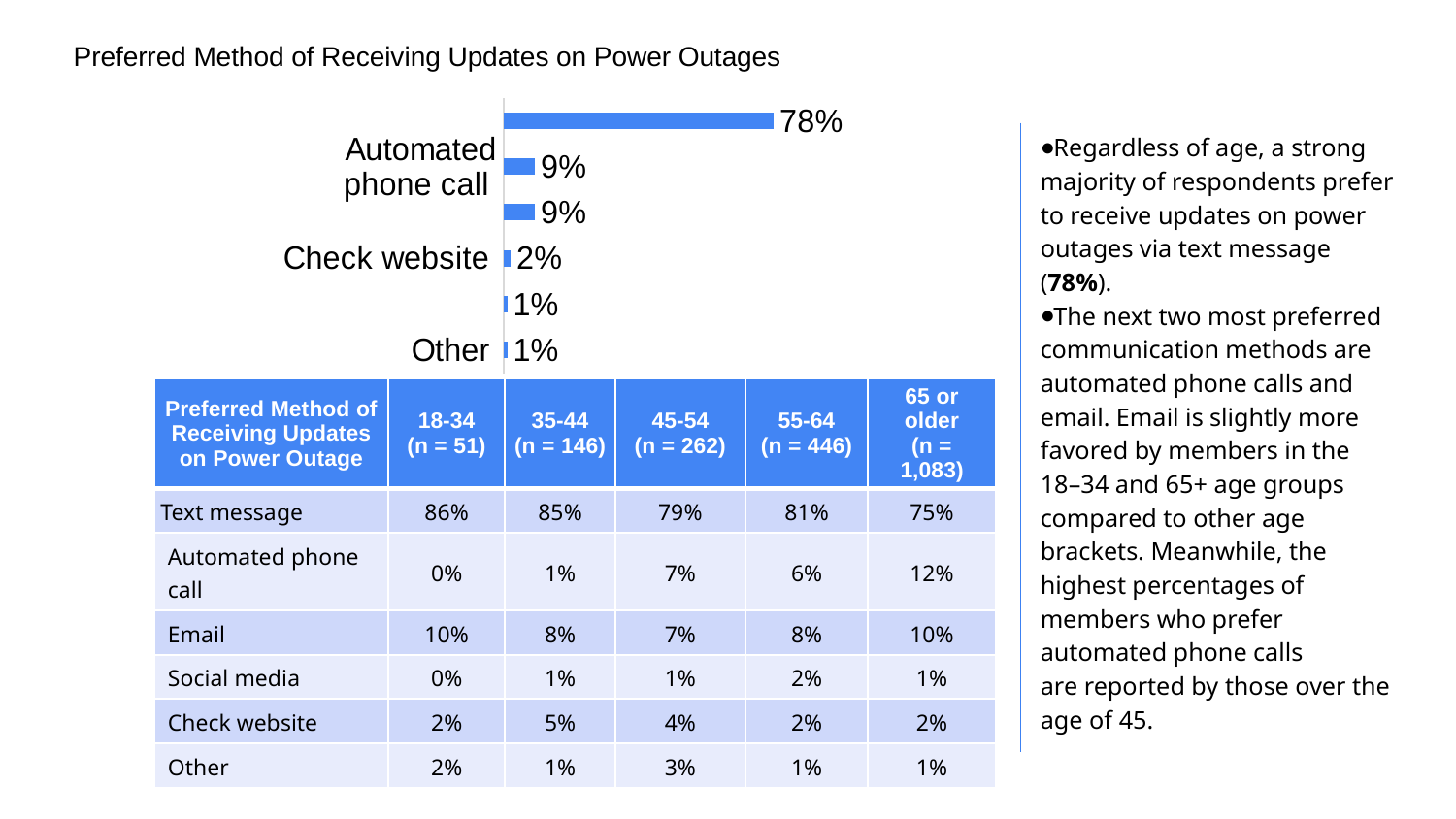
What is the title of the chart? Preferred Method of Receiving Updates on Power Outages What is the value for Automated phone call in the chart? 9% What colour are the bars in the chart? blue What is the value for Other in the chart? 1% What is the value for Check website in the chart? 2% What is the highest value shown on any bar in the chart? 78% Which is larger, the value for Check website or the value for Other? Check website What is the difference between the values for Automated phone call and Check website? 7 percentage points How many bars are plotted in the chart? 6 Which is larger, the value for Automated phone call or the value for Check website? Automated phone call What kind of chart is shown on the slide? bar chart Among the labeled categories Automated phone call, Check website and Other, which has the lowest value? Other